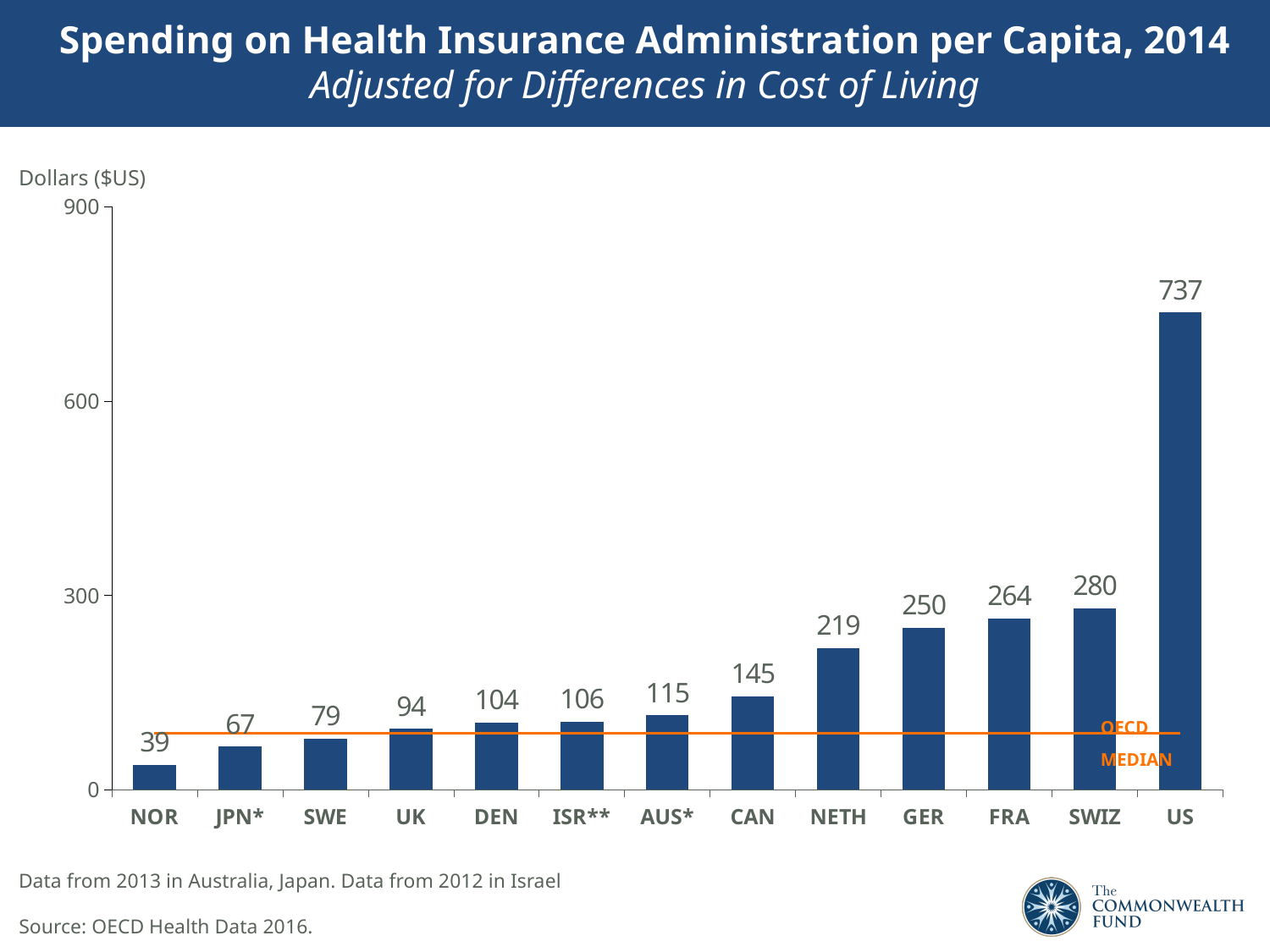
Which country has the highest spending on health insurance administration per capita? US What is the difference between the values for US and SWIZ? 457 What is the value shown for NETH? 219 Is the value for SWIZ greater or less than 300? less How many countries are shown on the chart? 13 Which country has the lowest spending on health insurance administration per capita? NOR What kind of chart is shown on the slide? bar chart What is the value shown for DEN? 104 What does the orange horizontal line on the chart represent? OECD median Which is larger, the value for FRA or the value for NETH? FRA What is the spending on health insurance administration per capita for the US? 737 What is the difference between the values for GER and CAN? 105